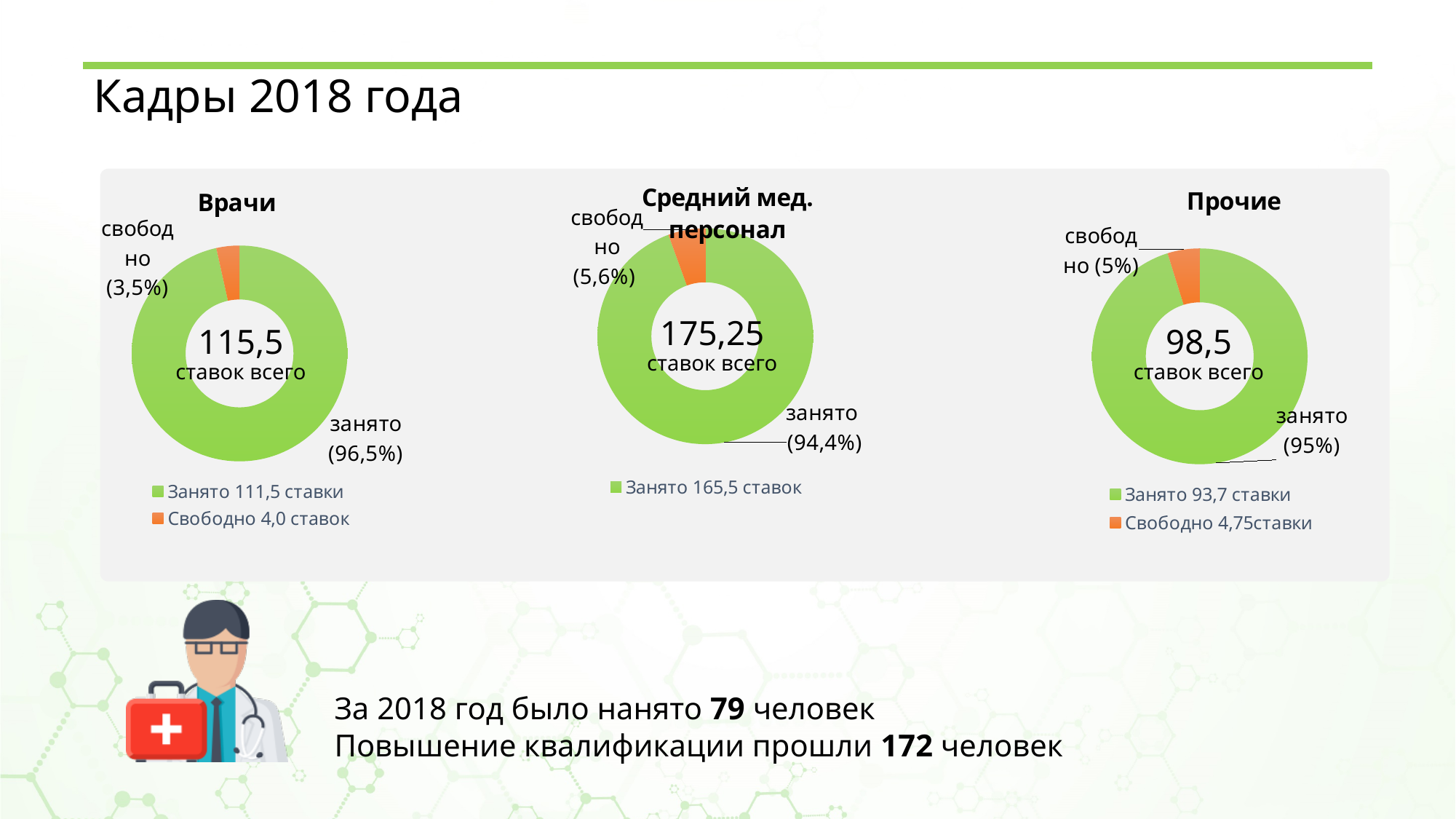
In the "Прочие" chart, what share of positions is shown as занято? 95% What kind of chart is used for "Прочие"? Donut (pie) chart In the "Врачи" chart, what share of positions is shown as занято? 96,5% In the "Врачи" chart, how many ставки are listed in the legend as Занято? 111,5 In the "Врачи" chart, which slice is larger, занято or свободно? занято In the "Врачи" chart, what share of positions is shown as свободно? 3,5% In the "Прочие" chart, how many ставки are listed in the legend as Свободно? 4,75 In the "Средний мед. персонал" chart, how many ставок are listed in the legend as Занято? 165,5 What total number of ставок is shown in the centre of the "Средний мед. персонал" chart? 175,25 How many slices does the "Прочие" chart have? 2 How many charts are shown on the slide? 3